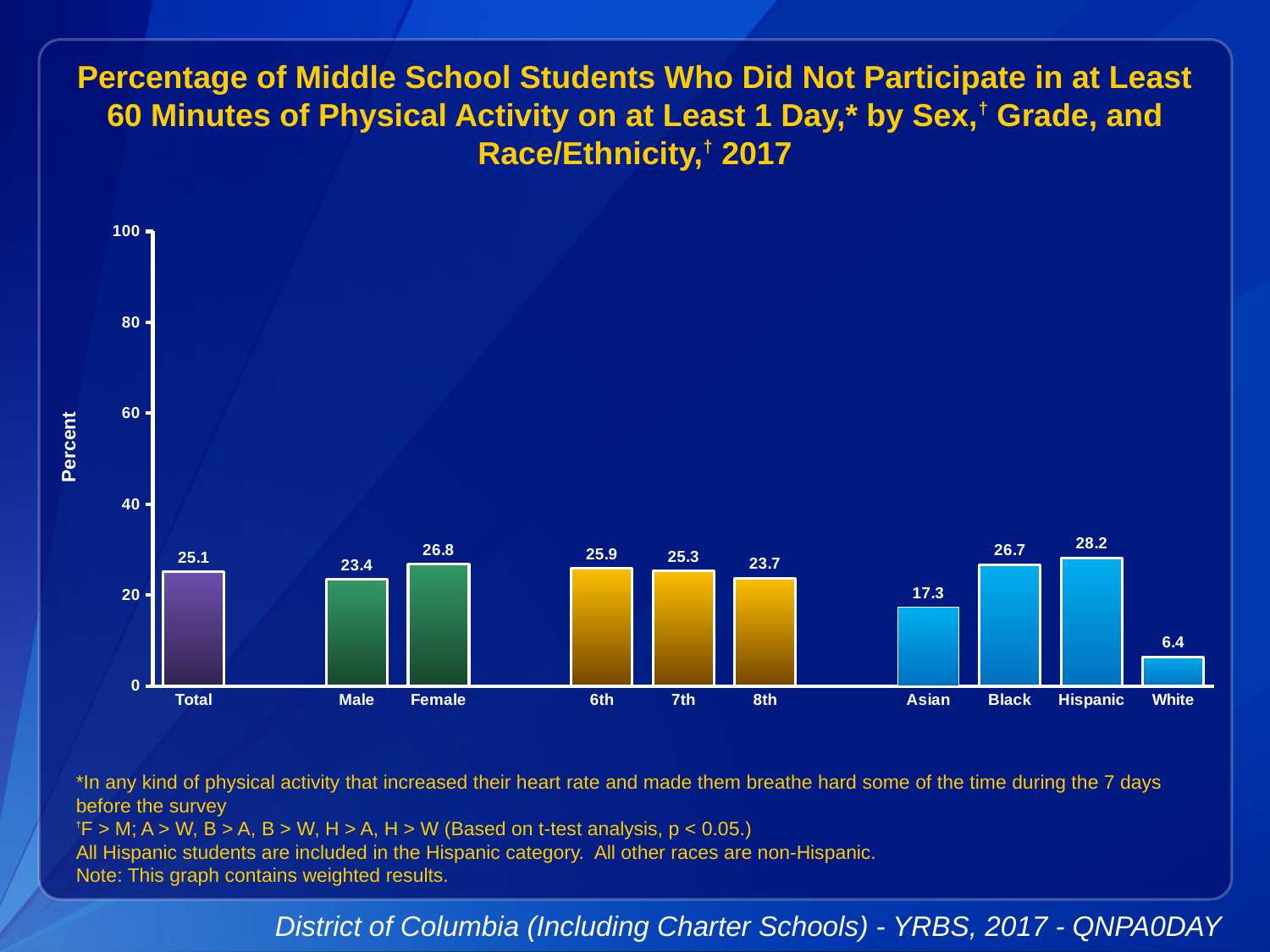
What is the value for Female? 26.8 What is the difference between the Female and Male values? 3.4 Which category has the lowest value? White Is the value for Hispanic greater or less than 20? greater What is the value for White? 6.4 Which is larger, the value for Black or the value for Asian? Black Which category has the highest value? Hispanic What is the value for 8th grade? 23.7 How many categories are shown on the x axis? 10 What is the value for Total? 25.1 What kind of chart is this? bar chart What is the label on the y axis? Percent